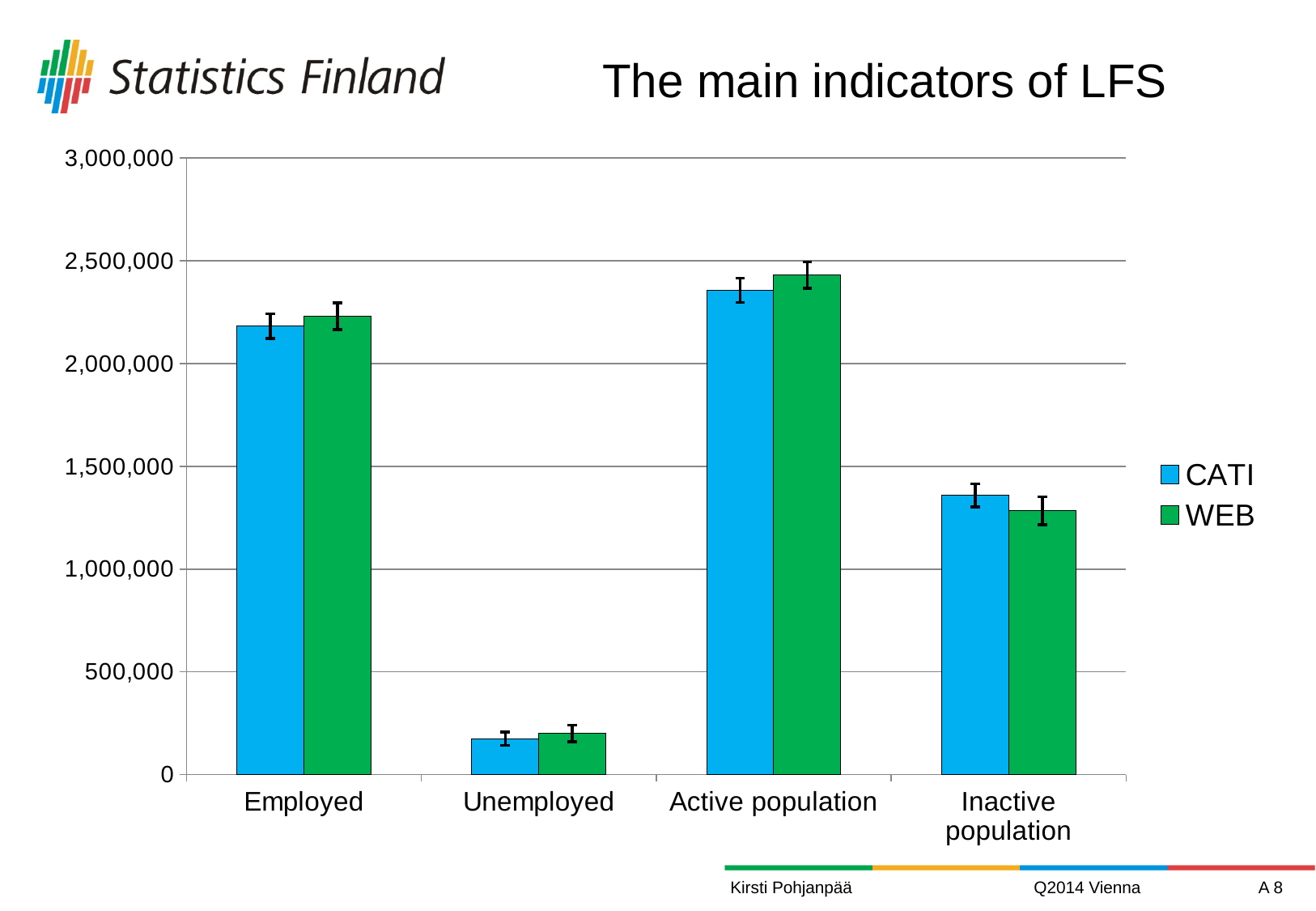
How many categories are shown on the x axis? 4 Is the CATI value for Inactive population greater or less than 1,500,000? less Which category has the highest CATI value? Active population For Active population, which series has the larger value, CATI or WEB? WEB Is the WEB value for Unemployed greater or less than 500,000? less What kind of chart is shown on the slide? bar chart What is the title of the chart? The main indicators of LFS Is the WEB value for Active population greater or less than 2,500,000? less How many series does the legend list? 2 For Inactive population, which series has the larger value, CATI or WEB? CATI Which category has the lowest WEB value? Unemployed